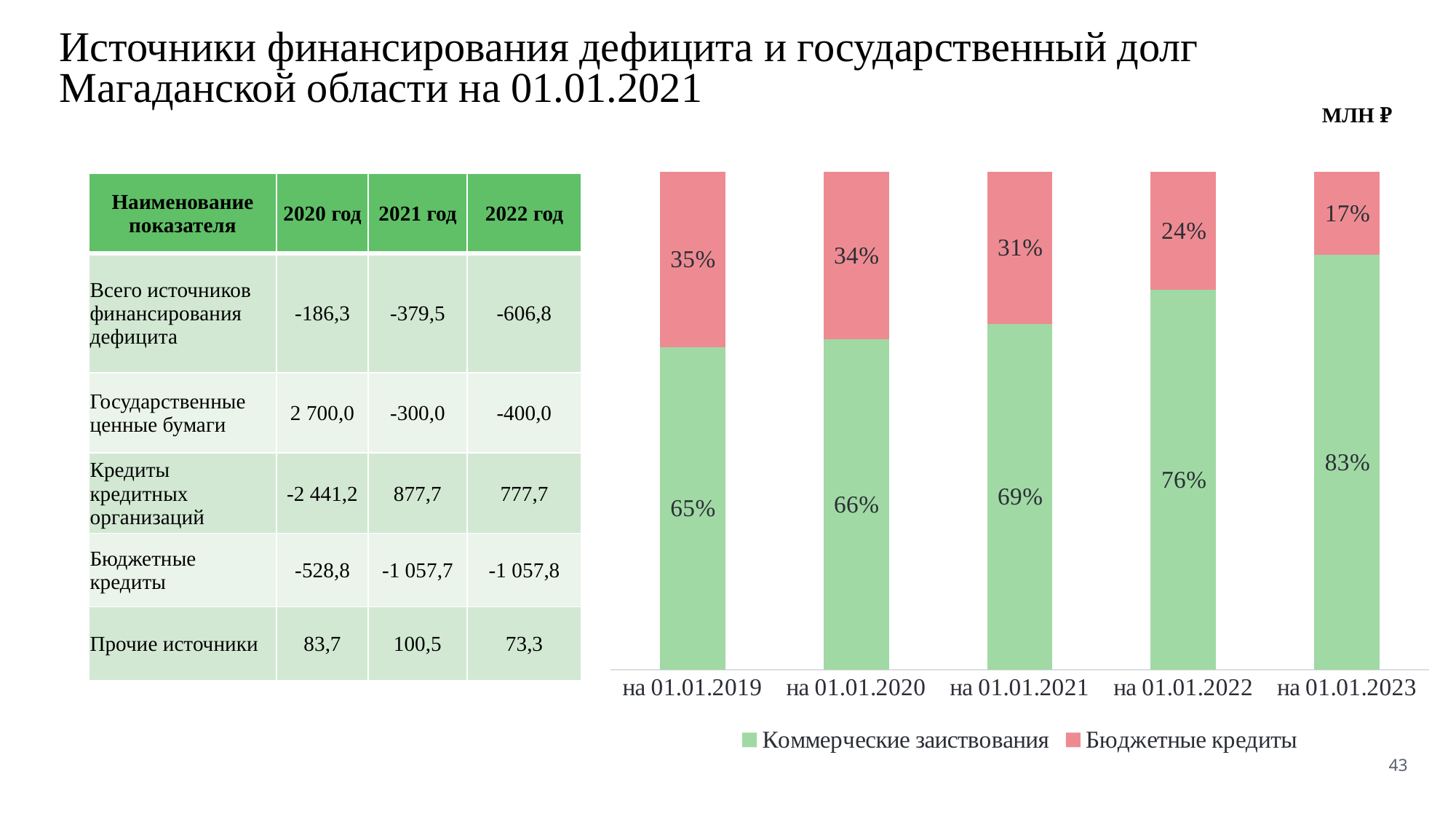
How many periods (bars) are shown on the chart? 5 What is the value of Бюджетные кредиты for на 01.01.2019? 35% What share of the bar for на 01.01.2023 is Коммерческие заимствования? 83% Which is larger for на 01.01.2020: Коммерческие заимствования or Бюджетные кредиты? Коммерческие заимствования By how many percentage points does Коммерческие заимствования for на 01.01.2023 exceed that for на 01.01.2019? 18% What is the value of Бюджетные кредиты for на 01.01.2022? 24% What is the value of Коммерческие заимствования for на 01.01.2021? 69% Does the share of Бюджетные кредиты rise or fall from на 01.01.2019 to на 01.01.2023? Fall How many series does the chart legend list? 2 What type of chart is shown on the slide? Stacked bar chart In which period is the share of Бюджетные кредиты the lowest? на 01.01.2023 In which period is the share of Коммерческие заимствования the highest? на 01.01.2023